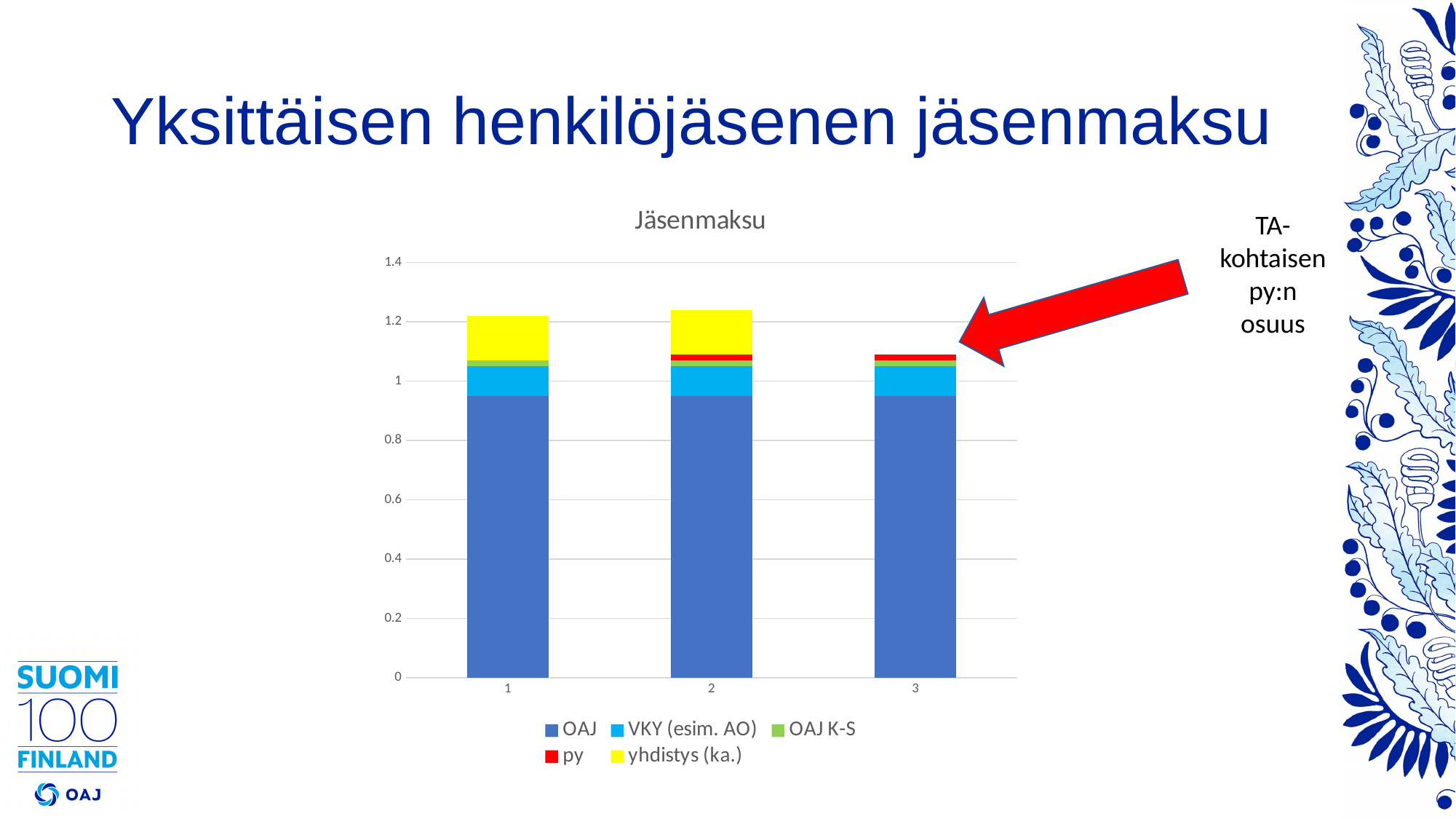
Is the total for category 3 greater or less than 1.2? less How many series does the legend list? 5 Is the OAJ segment for category 1 greater or less than 0.8? greater Which has a larger total bar height, category 1 or category 3? category 1 Is the total for category 1 greater or less than 1? greater How many bars (categories) are shown in the chart? 3 Which category has the lowest total bar height? 3 Which series is shown in red in the legend? py What is the title of the chart? Jäsenmaksu What type of chart is shown on the slide? stacked bar chart